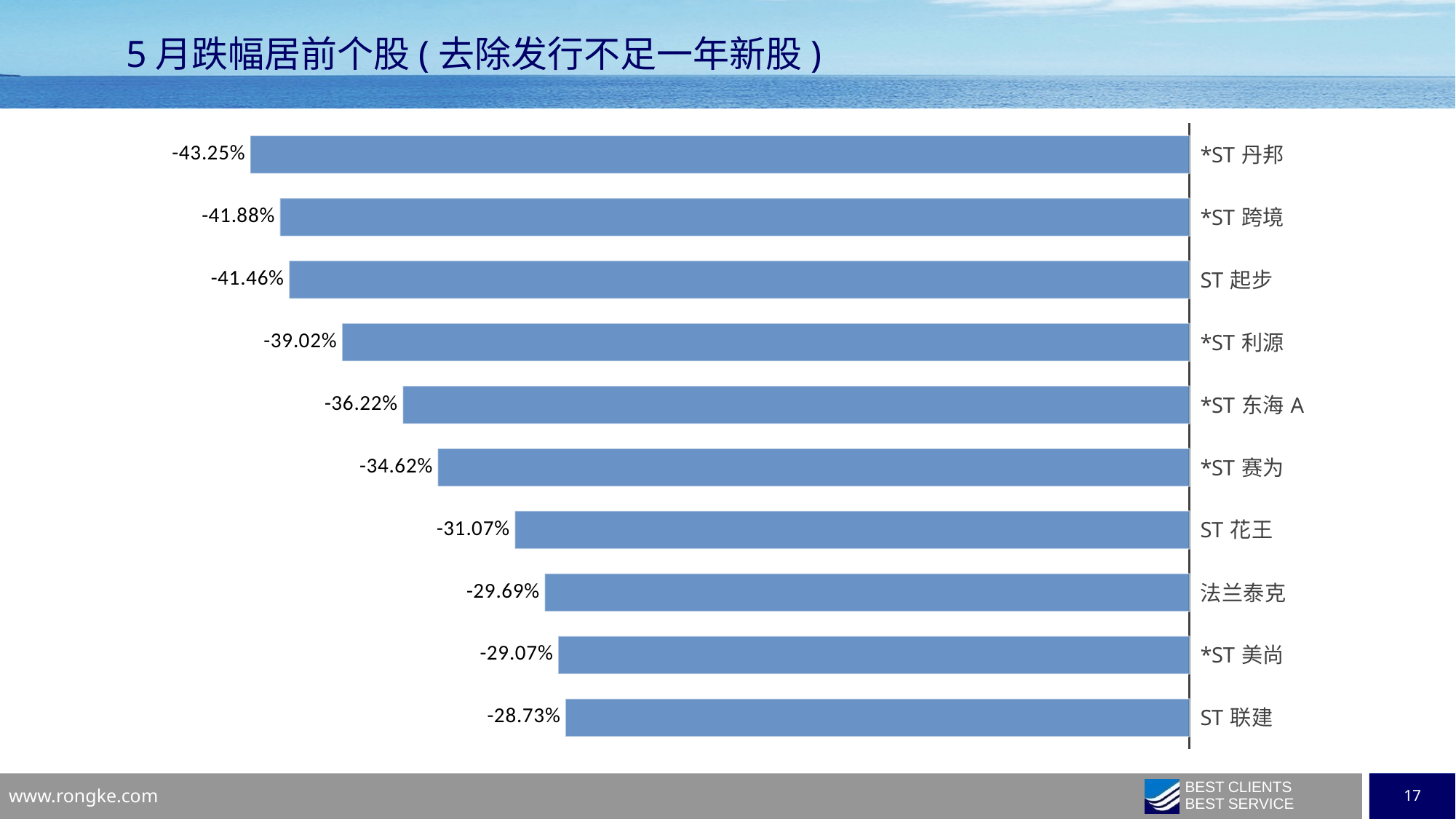
What is the value shown for *ST 东海 A? -36.22% Which stock has the smallest decline (the least negative value) on the chart? ST 联建 Which stock has the largest decline (the most negative value) on the chart? *ST 丹邦 What is the title of the slide? 5 月跌幅居前个股 ( 去除发行不足一年新股 ) What is the value shown for ST 花王? -31.07% What is the difference in percentage points between the values for *ST 丹邦 and ST 联建? 14.52 percentage points How many stocks are shown on the chart? 10 What is the value shown for *ST 丹邦? -43.25% What is the difference in percentage points between the values for *ST 东海 A and *ST 赛为? 1.60 percentage points Which stock fell more in May, *ST 利源 or *ST 美尚? *ST 利源 What is the value shown for 法兰泰克? -29.69% What type of chart is shown on the slide? Bar chart